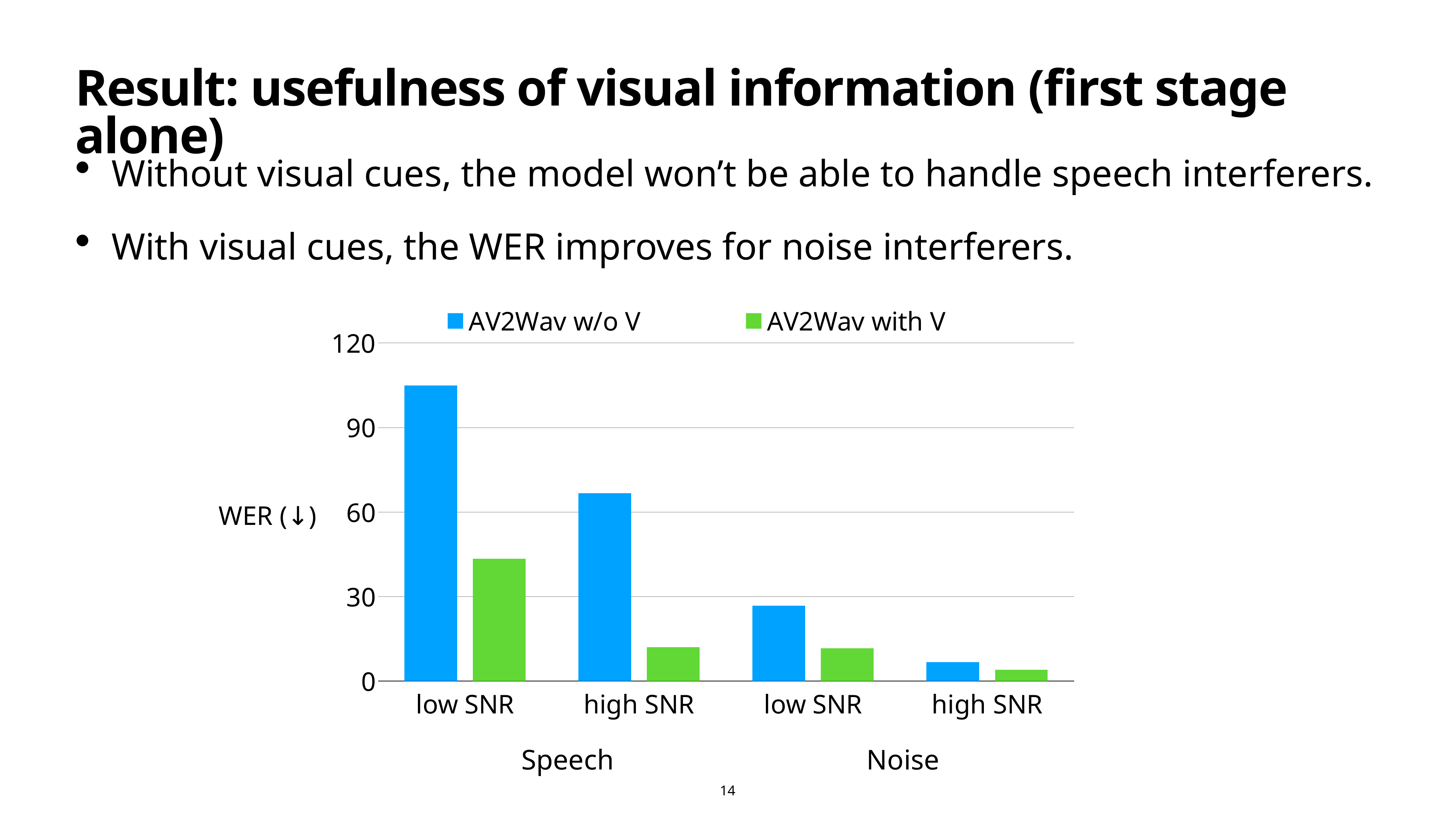
Is the WER for AV2Wav with V at low SNR under Speech greater or less than 60? less What kind of chart is shown on the slide? bar chart Is the WER for AV2Wav w/o V at high SNR under Speech greater or less than 60? greater Is the WER for AV2Wav w/o V at low SNR under Speech greater or less than 90? greater How many series does the legend list? 2 Which category has the lowest WER for AV2Wav with V? high SNR (Noise) What is the label of the y axis? WER (↓) How many category groups are shown along the x axis? 4 What are the two series named in the legend? AV2Wav w/o V and AV2Wav with V For low SNR under Speech, which series has the larger WER, AV2Wav w/o V or AV2Wav with V? AV2Wav w/o V Which category has the highest WER for AV2Wav w/o V? low SNR (Speech)